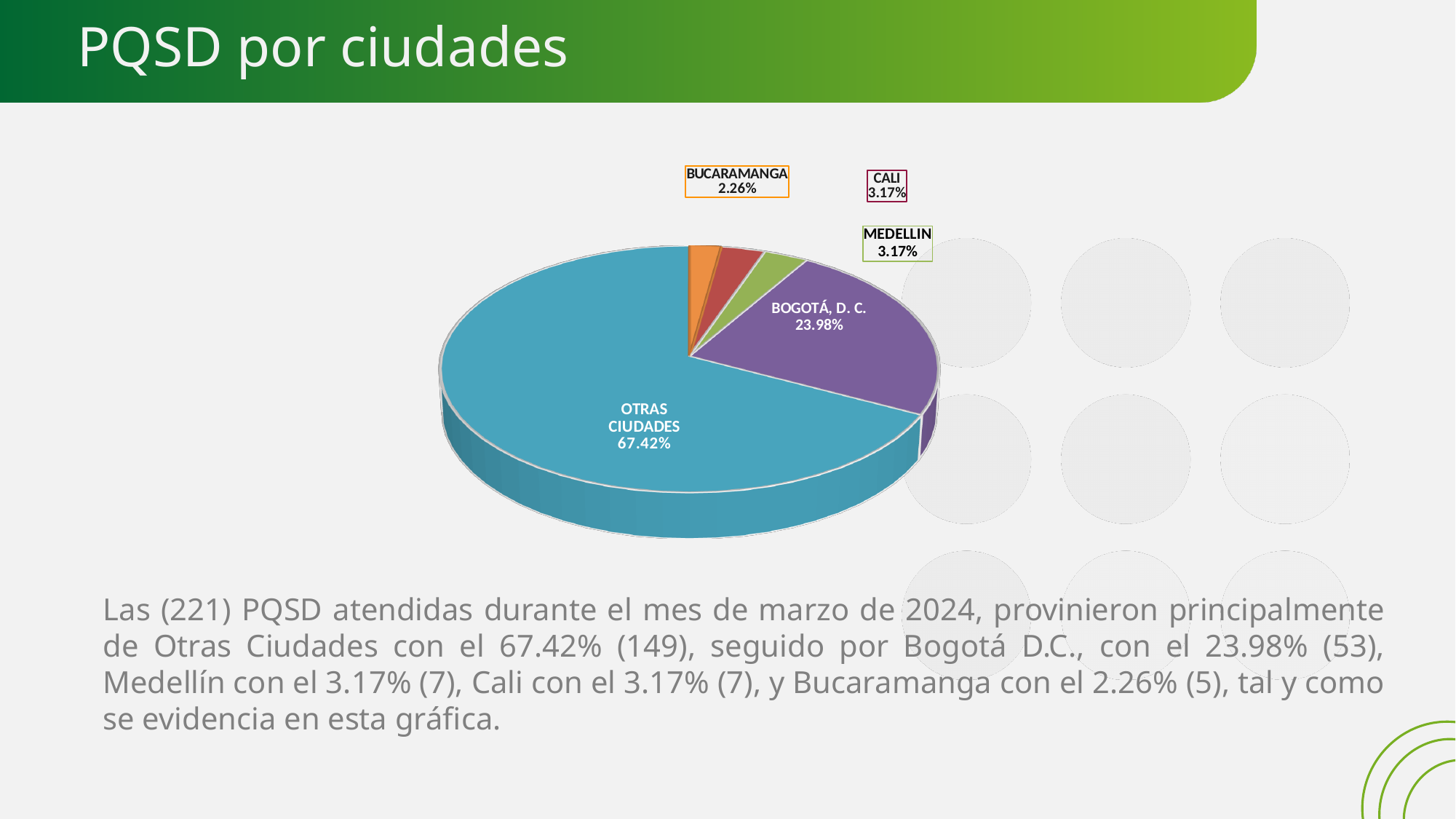
What share of the pie does BUCARAMANGA hold? 2.26% What kind of chart is shown on the slide? Pie chart Which category has the smallest slice of the pie? BUCARAMANGA What share of the pie does MEDELLIN hold? 3.17% How many slices does the pie chart have? 5 What is the difference in percentage points between OTRAS CIUDADES and BOGOTÁ, D. C.? 43.44 Which category has the largest slice of the pie? OTRAS CIUDADES Which is larger, the slice for BOGOTÁ, D. C. or the slice for CALI? BOGOTÁ, D. C. What share of the pie does OTRAS CIUDADES hold? 67.42% What share of the pie does BOGOTÁ, D. C. hold? 23.98% What is the title of the slide containing the pie chart? PQSD por ciudades What share of the pie does CALI hold? 3.17%